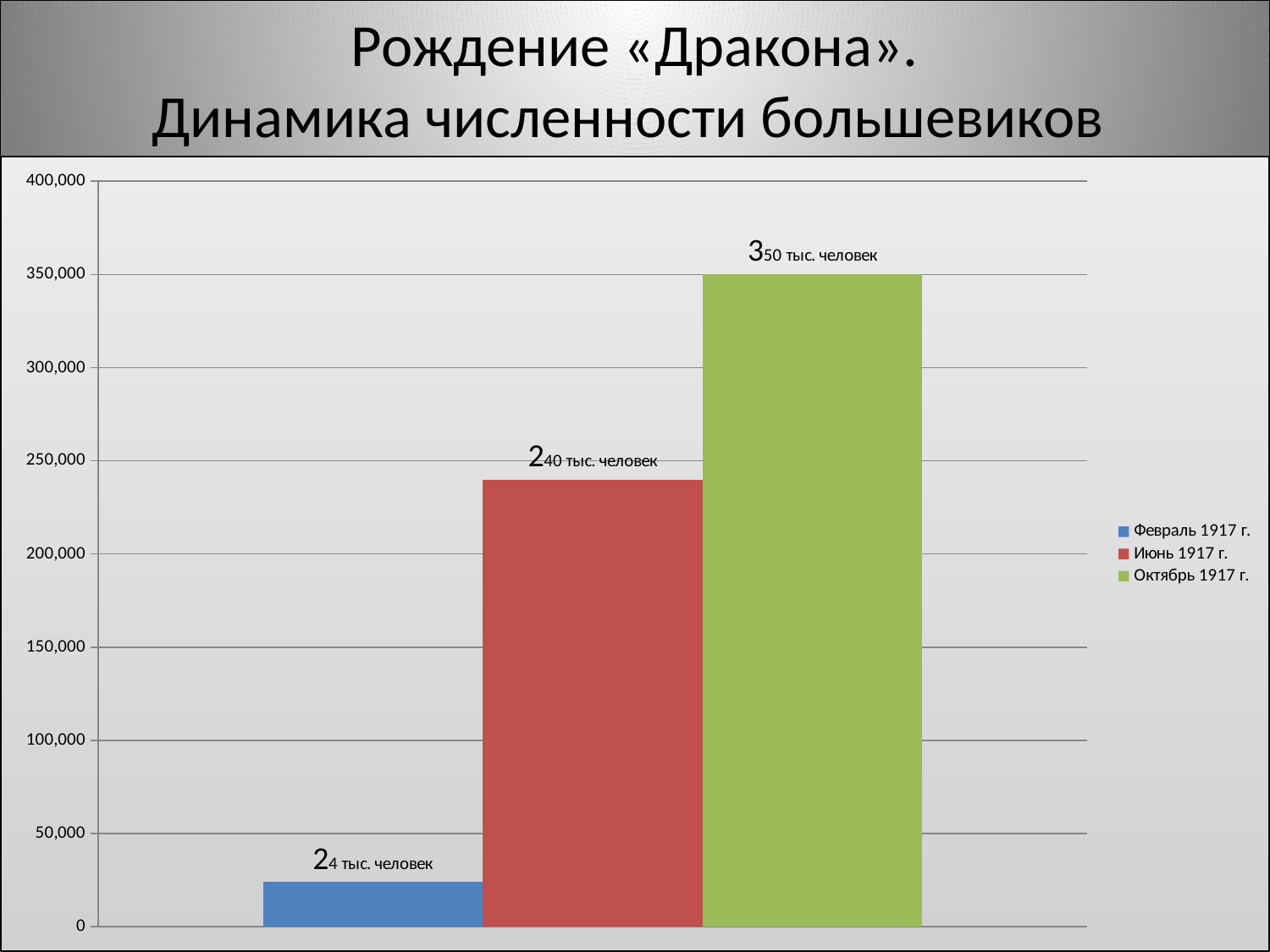
How many series does the legend list? 3 What is the difference between the values for Октябрь 1917 г. and Июнь 1917 г.? 110 тыс. человек What is the difference between the values for Июнь 1917 г. and Февраль 1917 г.? 216 тыс. человек Which series has the highest value? Октябрь 1917 г. Is the value for Июнь 1917 г. greater or less than 200,000? greater What kind of chart is shown on the slide? bar chart What is the value for Февраль 1917 г.? 24 тыс. человек Do the values rise or fall from Февраль 1917 г. to Октябрь 1917 г.? rise Which is larger, the value for Июнь 1917 г. or Февраль 1917 г.? Июнь 1917 г. What is the value for Октябрь 1917 г.? 350 тыс. человек Which series has the lowest value? Февраль 1917 г. What is the value for Июнь 1917 г.? 240 тыс. человек